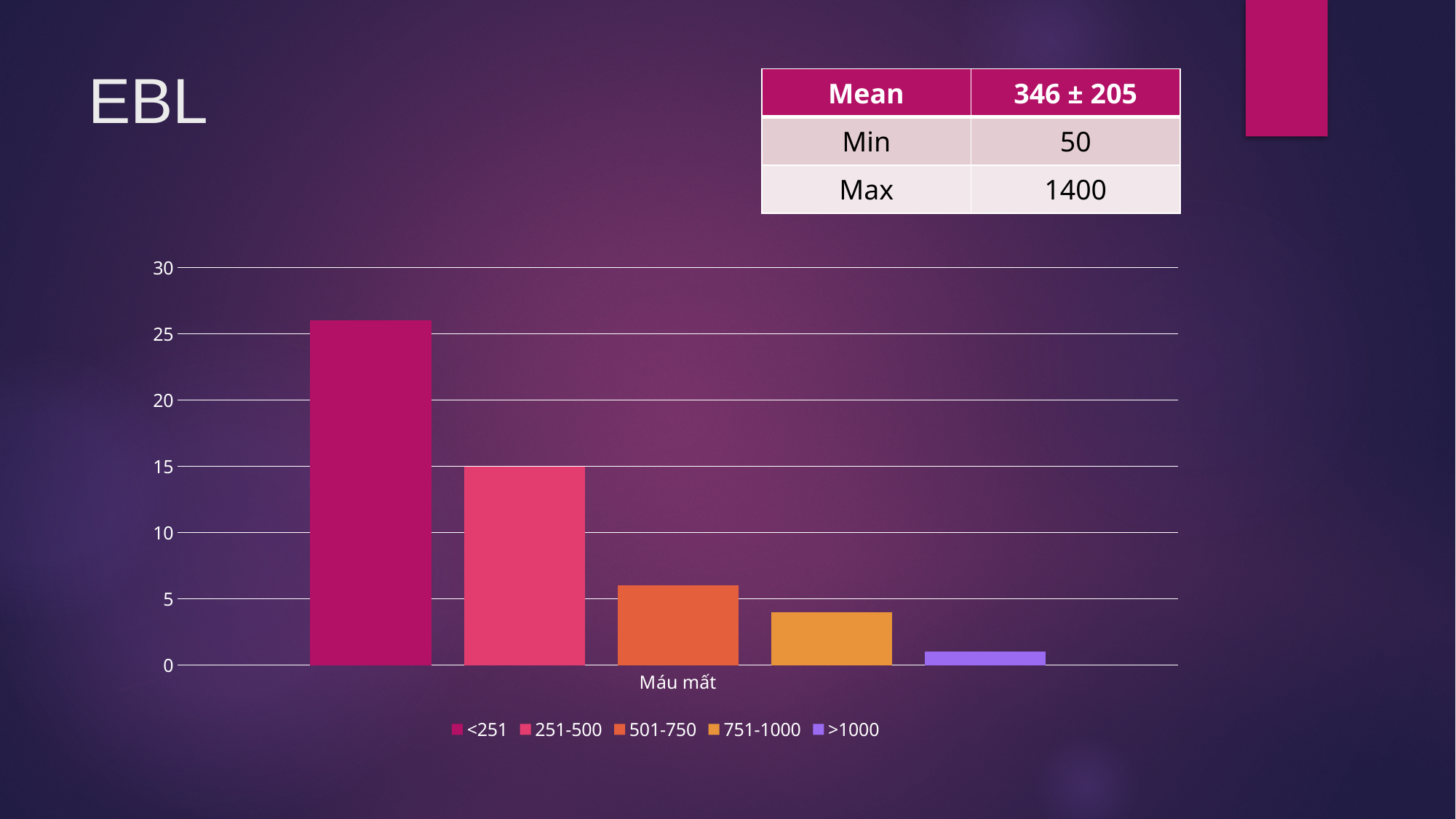
How many series does the chart legend list? 5 What is the category label shown on the x axis of the chart? Máu mất Is the value for 501-750 greater or less than 5? greater Which series has the lowest bar in the chart? >1000 What is the title of the slide containing the chart? EBL What is the value of the 251-500 bar? 15 Which series has the highest bar in the chart? <251 Is the value for <251 greater or less than 25? greater Which is larger, the bar for 251-500 or the bar for 501-750? 251-500 Is the value for >1000 greater or less than 5? less What kind of chart is shown on the slide? bar chart